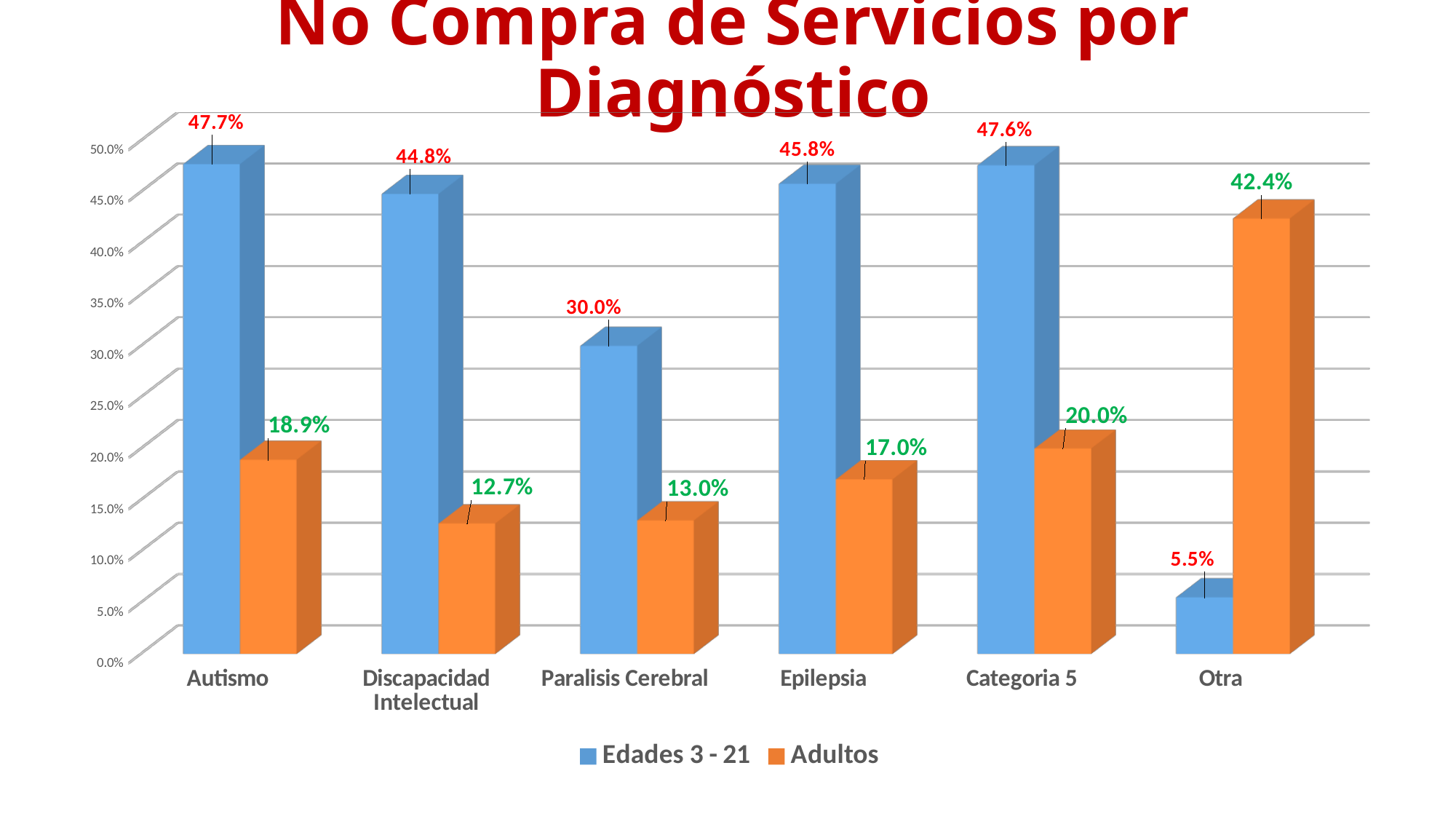
What is the difference between the Edades 3 - 21 and Adultos values for Epilepsia? 28.8% What is the title of the chart? No Compra de Servicios por Diagnóstico Which is larger for Otra: the Edades 3 - 21 value or the Adultos value? Adultos Which category has the highest value in the Edades 3 - 21 series? Autismo Which category has the lowest value in the Edades 3 - 21 series? Otra What is the value for Otra in the Adultos series? 42.4% How many categories are shown on the x axis? 6 How many series does the legend list? 2 What kind of chart is shown on the slide? Bar chart Which category has the lowest value in the Adultos series? Discapacidad Intelectual What is the value for Autismo in the Edades 3 - 21 series? 47.7% What is the value for Paralisis Cerebral in the Edades 3 - 21 series? 30.0%